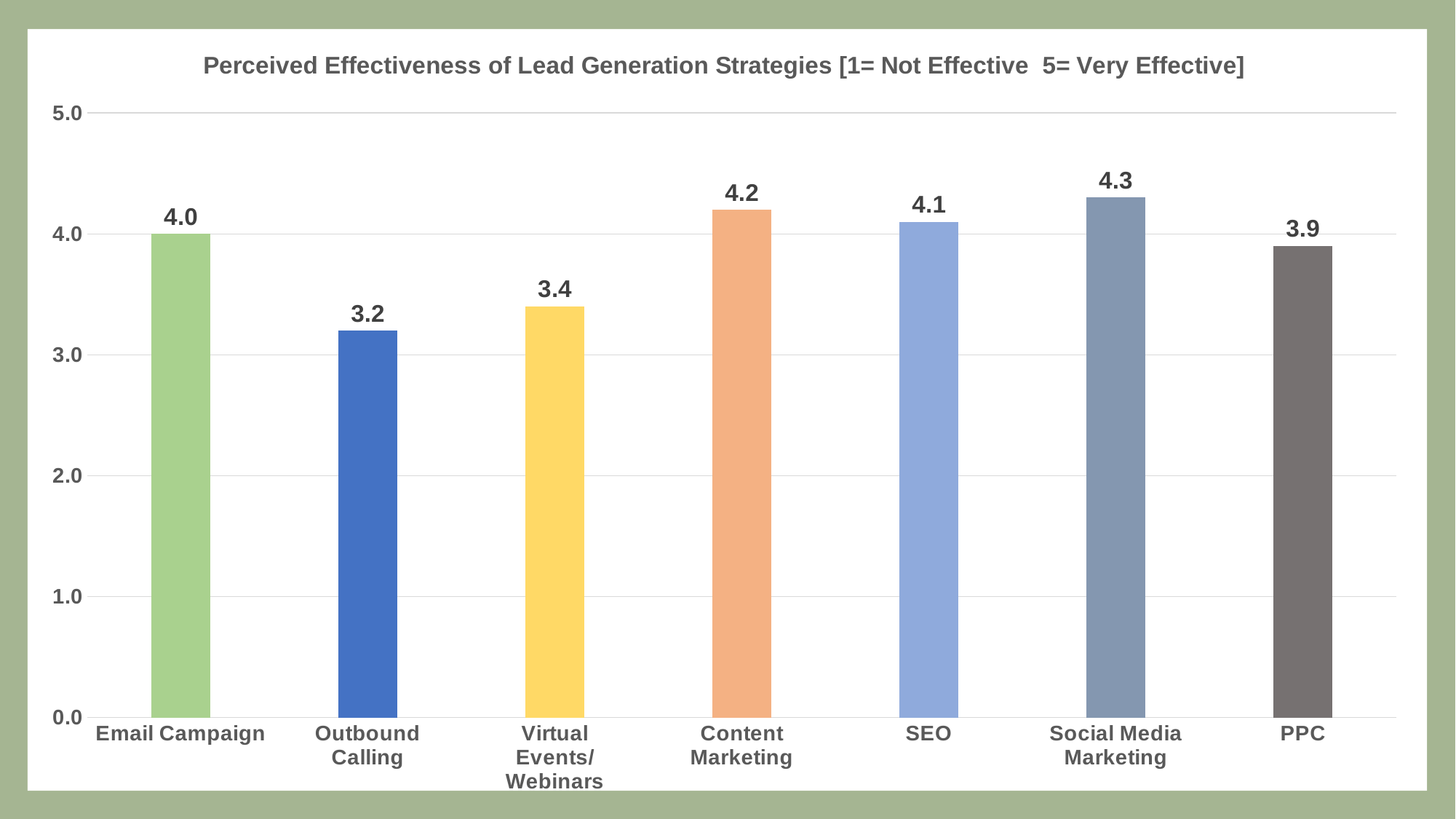
Which has a higher perceived effectiveness score, Content Marketing or PPC? Content Marketing What type of chart is shown on the slide? Bar chart What is the perceived effectiveness score for PPC? 3.9 What is the perceived effectiveness score for Outbound Calling? 3.2 How many lead generation strategies are shown in the chart? 7 Which lead generation strategy has the lowest perceived effectiveness score? Outbound Calling What is the perceived effectiveness score for Email Campaign? 4.0 What is the difference between the scores for Social Media Marketing and Outbound Calling? 1.1 What is the perceived effectiveness score for Virtual Events/Webinars? 3.4 What is the title of the chart? Perceived Effectiveness of Lead Generation Strategies [1= Not Effective 5= Very Effective] What is the difference between the scores for Content Marketing and SEO? 0.1 Which lead generation strategy has the highest perceived effectiveness score? Social Media Marketing